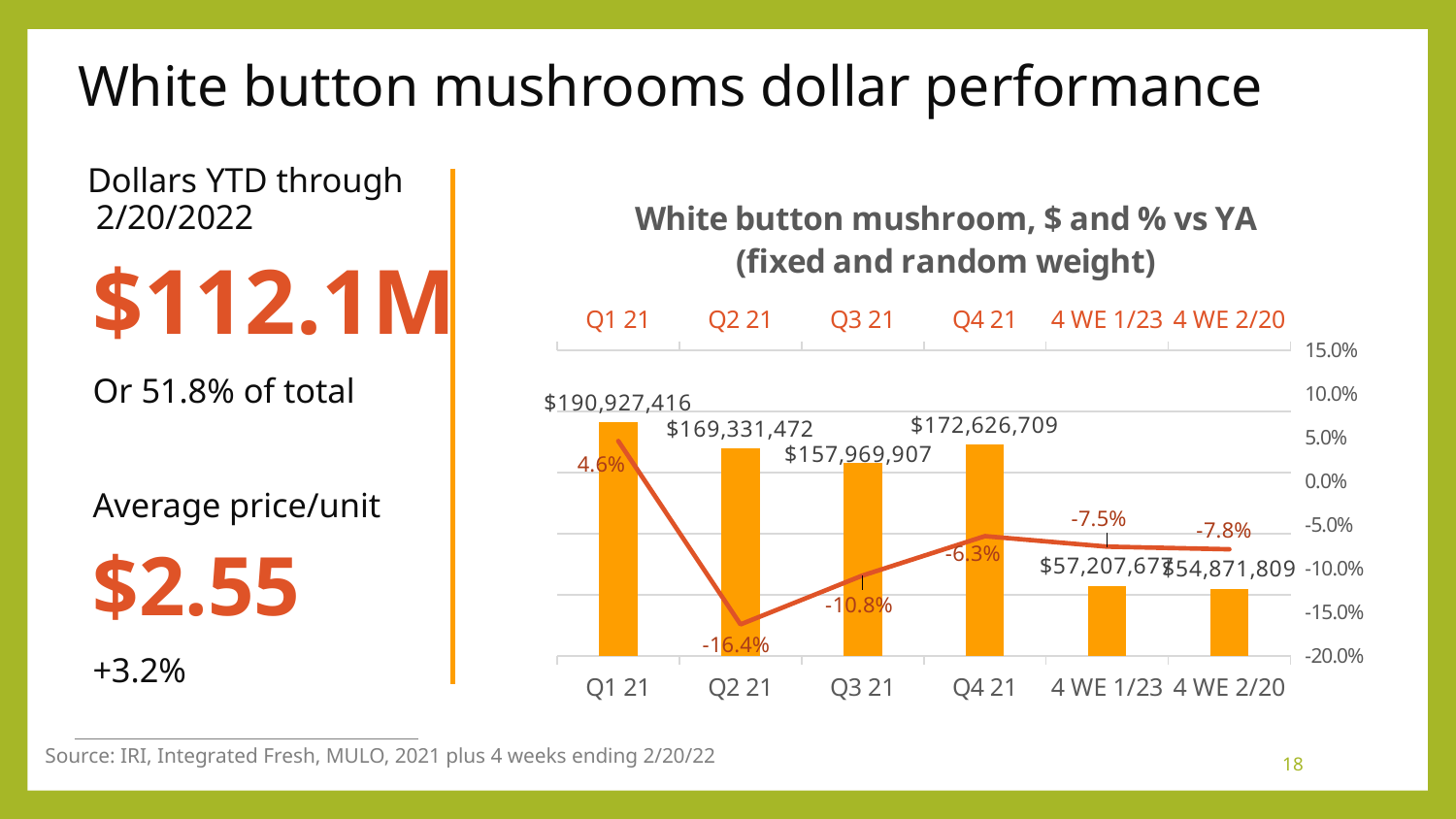
What kind of chart is this? Combination bar and line chart What is the % vs YA value for 4 WE 2/20? -7.8% What is the dollar value shown for Q1 21? $190,927,416 What is the % vs YA value for Q2 21? -16.4% Which has the larger dollar value, Q3 21 or Q4 21? Q4 21 Which period has the lowest % vs YA value on the line? Q2 21 How many periods are shown on the x axis? 6 Which period has the highest dollar value bar? Q1 21 What is the title of the chart? White button mushroom, $ and % vs YA (fixed and random weight) What is the difference between the Q1 21 and Q2 21 dollar values? $21,595,944 What is the dollar value shown for Q3 21? $157,969,907 Is the % vs YA value for Q4 21 greater or less than -5.0%? less